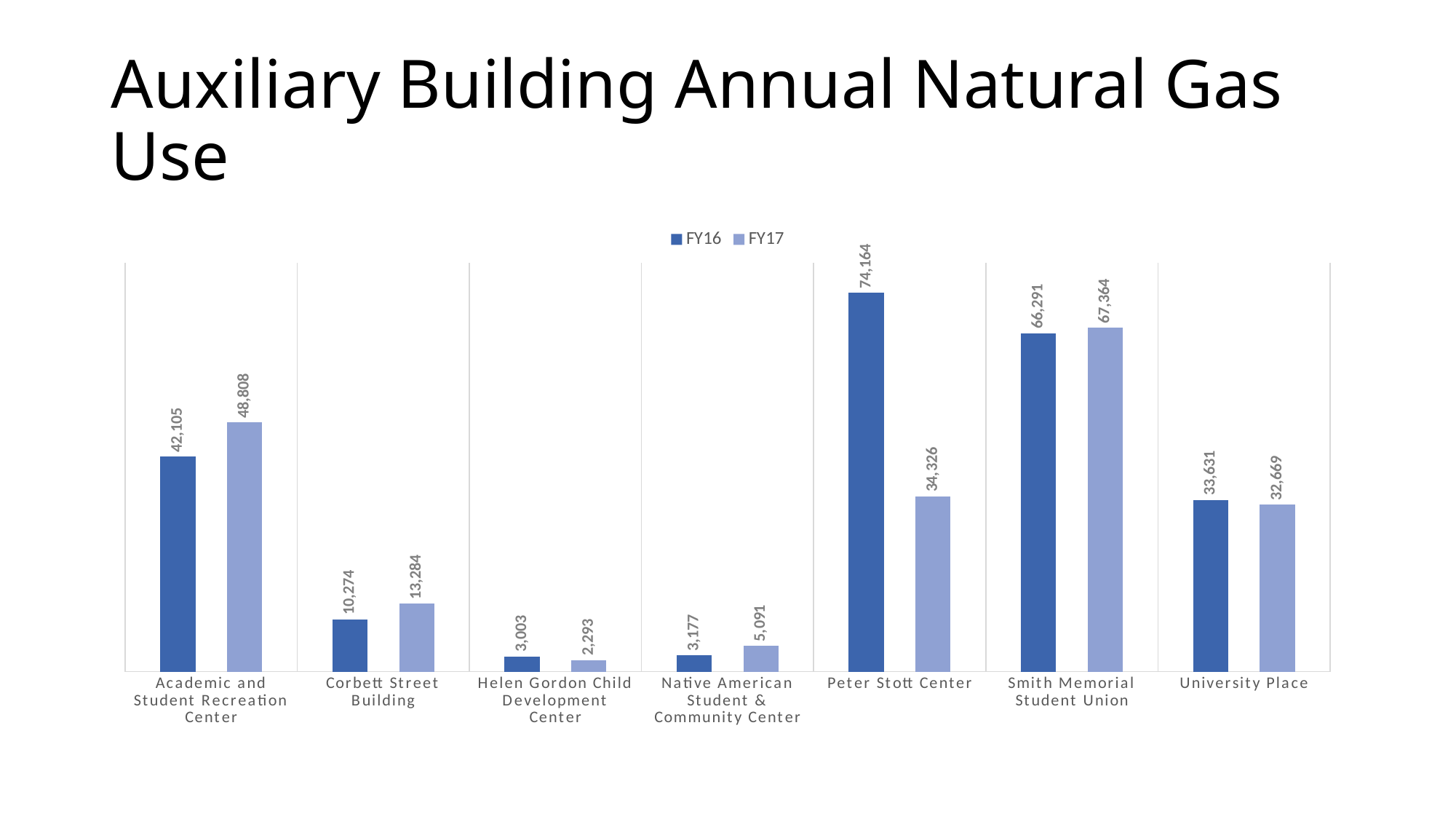
Which building has the lowest FY17 value? Helen Gordon Child Development Center How many series does the legend list? 2 Which is larger for Academic and Student Recreation Center, the FY16 value or the FY17 value? FY17 How many buildings are shown on the x axis? 7 What is the FY16 value for Peter Stott Center? 74,164 Which building has the highest FY16 value? Peter Stott Center What is the FY17 value for Native American Student & Community Center? 5,091 What are the two series listed in the legend? FY16 and FY17 What is the FY17 value for Corbett Street Building? 13,284 What kind of chart is shown on the slide? Bar chart What is the difference between the FY16 and FY17 values for Peter Stott Center? 39,838 What is the difference between the FY17 and FY16 values for Smith Memorial Student Union? 1,073